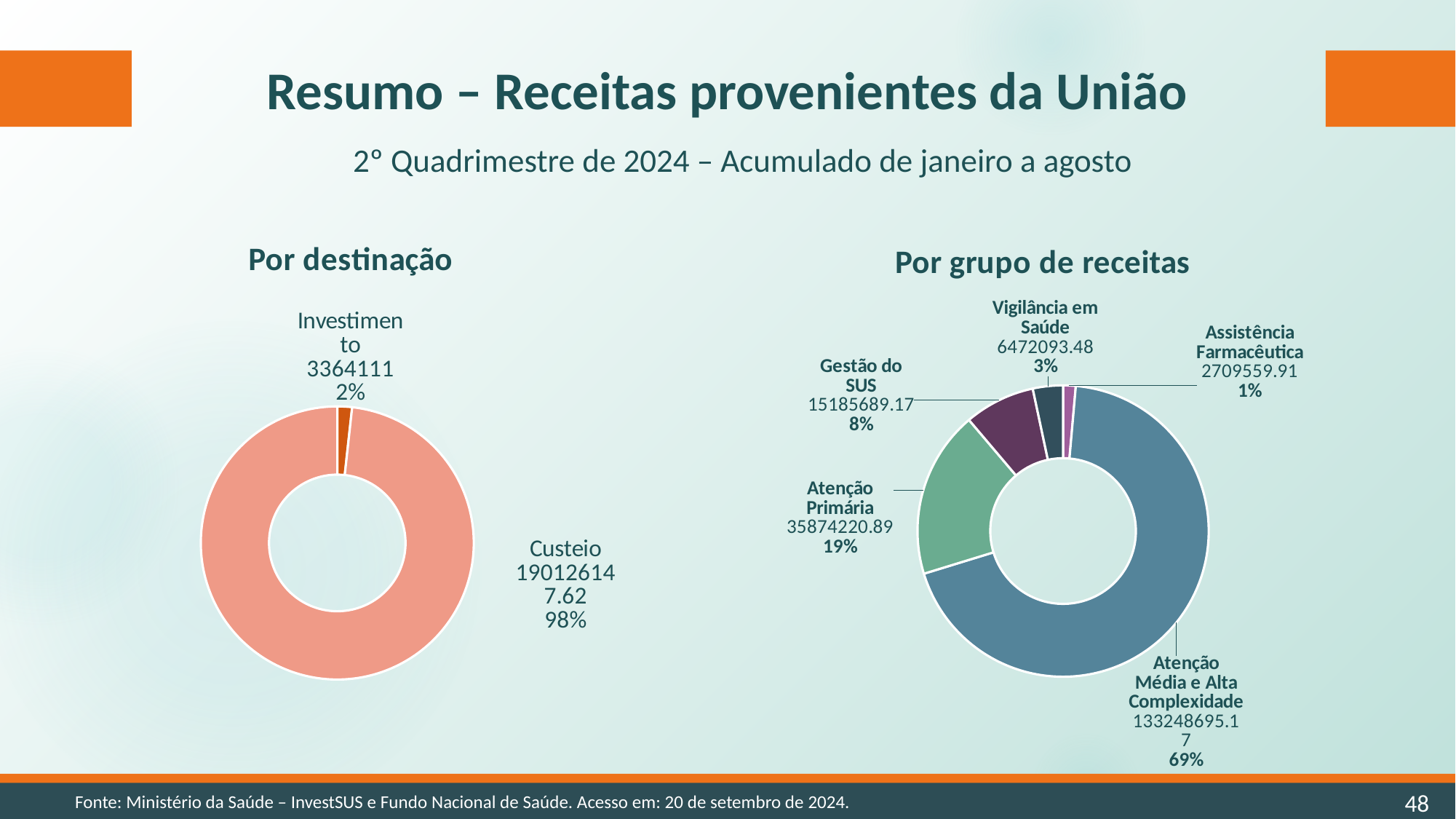
In the 'Por grupo de receitas' chart, what share of the total does Gestão do SUS represent? 8% In the 'Por destinação' chart, what is the difference between Custeio and Investimento? 186762036.62 In the 'Por destinação' chart, what share of the total does Investimento represent? 2% In the 'Por grupo de receitas' chart, what is the difference between Vigilância em Saúde and Assistência Farmacêutica? 3762533.57 What kind of chart is the 'Por destinação' chart? Doughnut chart In the 'Por grupo de receitas' chart, which category has the smallest value? Assistência Farmacêutica In the 'Por grupo de receitas' chart, how many categories are shown? 5 In the 'Por grupo de receitas' chart, what is the value for Atenção Primária? 35874220.89 In the 'Por destinação' chart, how many categories are shown? 2 In the 'Por destinação' chart, what is the value for Custeio? 190126147.62 In the 'Por grupo de receitas' chart, which category has the largest value? Atenção Média e Alta Complexidade In the 'Por grupo de receitas' chart, which is larger: Vigilância em Saúde or Gestão do SUS? Gestão do SUS